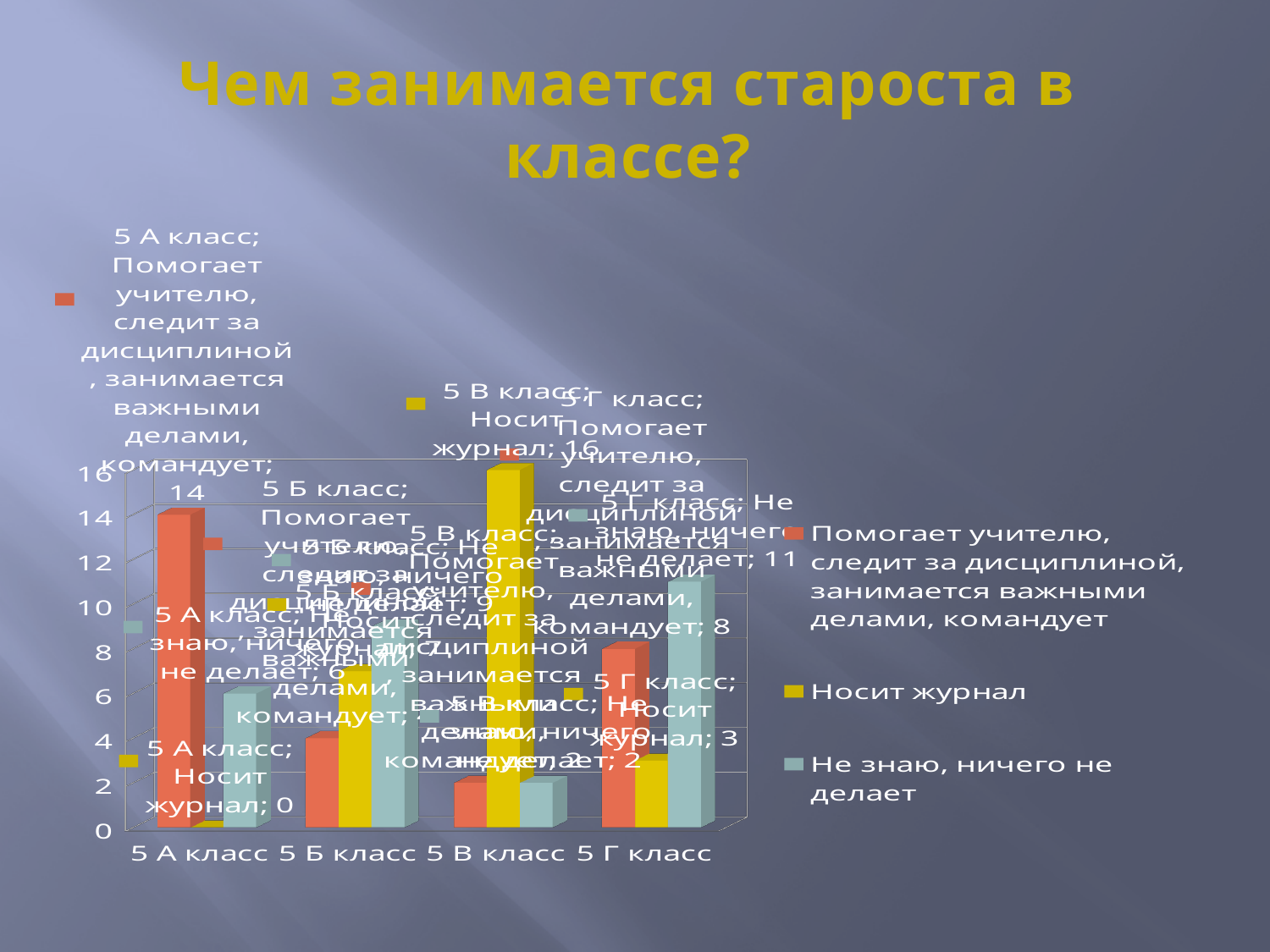
What is the value for 'Носит журнал' in 5 А класс? 0 What is the value for 'Носит журнал' in 5 В класс? 16 How many series does the legend list? 3 In 5 А класс, what is the difference between 'Помогает учителю, следит за дисциплиной, занимается важными делами, командует' (14) and 'Не знаю, ничего не делает' (6)? 8 What is the value for 'Помогает учителю, следит за дисциплиной, занимается важными делами, командует' in 5 А класс? 14 What is the value for 'Не знаю, ничего не делает' in 5 Г класс? 11 What is the value for 'Носит журнал' in 5 Г класс? 3 What kind of chart is shown on the slide? bar chart How many classes (categories) are shown on the x axis? 4 Which class has the highest value for 'Носит журнал'? 5 В класс What is the title of the chart slide? Чем занимается староста в классе? In 5 Г класс, which is larger: 'Не знаю, ничего не делает' or 'Помогает учителю, следит за дисциплиной, занимается важными делами, командует'? Не знаю, ничего не делает